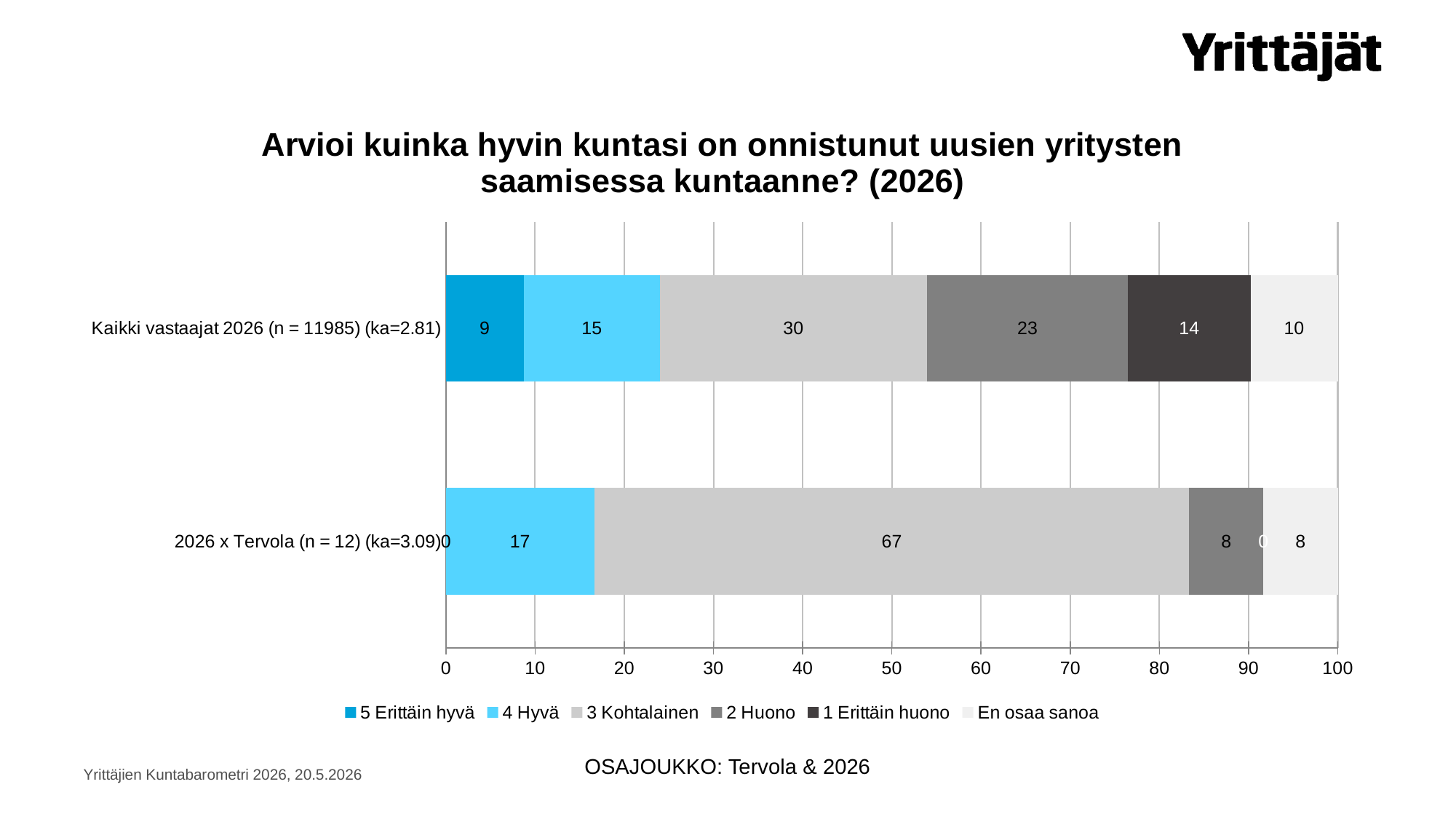
What is the value of "1 Erittäin huono" for "Kaikki vastaajat 2026 (n = 11985) (ka=2.81)"? 14 What is the value of "3 Kohtalainen" for "2026 x Tervola (n = 12) (ka=3.09)"? 67 What is the total of the stacked bar for "2026 x Tervola (n = 12) (ka=3.09)"? 100 Which series has the largest value in the "2026 x Tervola (n = 12) (ka=3.09)" bar? 3 Kohtalainen What is the difference between the "3 Kohtalainen" values for "2026 x Tervola (n = 12) (ka=3.09)" and "Kaikki vastaajat 2026 (n = 11985) (ka=2.81)"? 37 Which category has the larger value for "4 Hyvä": "Kaikki vastaajat 2026 (n = 11985) (ka=2.81)" or "2026 x Tervola (n = 12) (ka=3.09)"? 2026 x Tervola (n = 12) (ka=3.09) How many series does the legend list? 6 How many categories (bars) are plotted in the chart? 2 What is the value of "5 Erittäin hyvä" for "2026 x Tervola (n = 12) (ka=3.09)"? 0 What is the value of "2 Huono" for "Kaikki vastaajat 2026 (n = 11985) (ka=2.81)"? 23 What kind of chart is shown on the slide? Stacked bar chart Which series has the smallest value in the "Kaikki vastaajat 2026 (n = 11985) (ka=2.81)" bar? 5 Erittäin hyvä